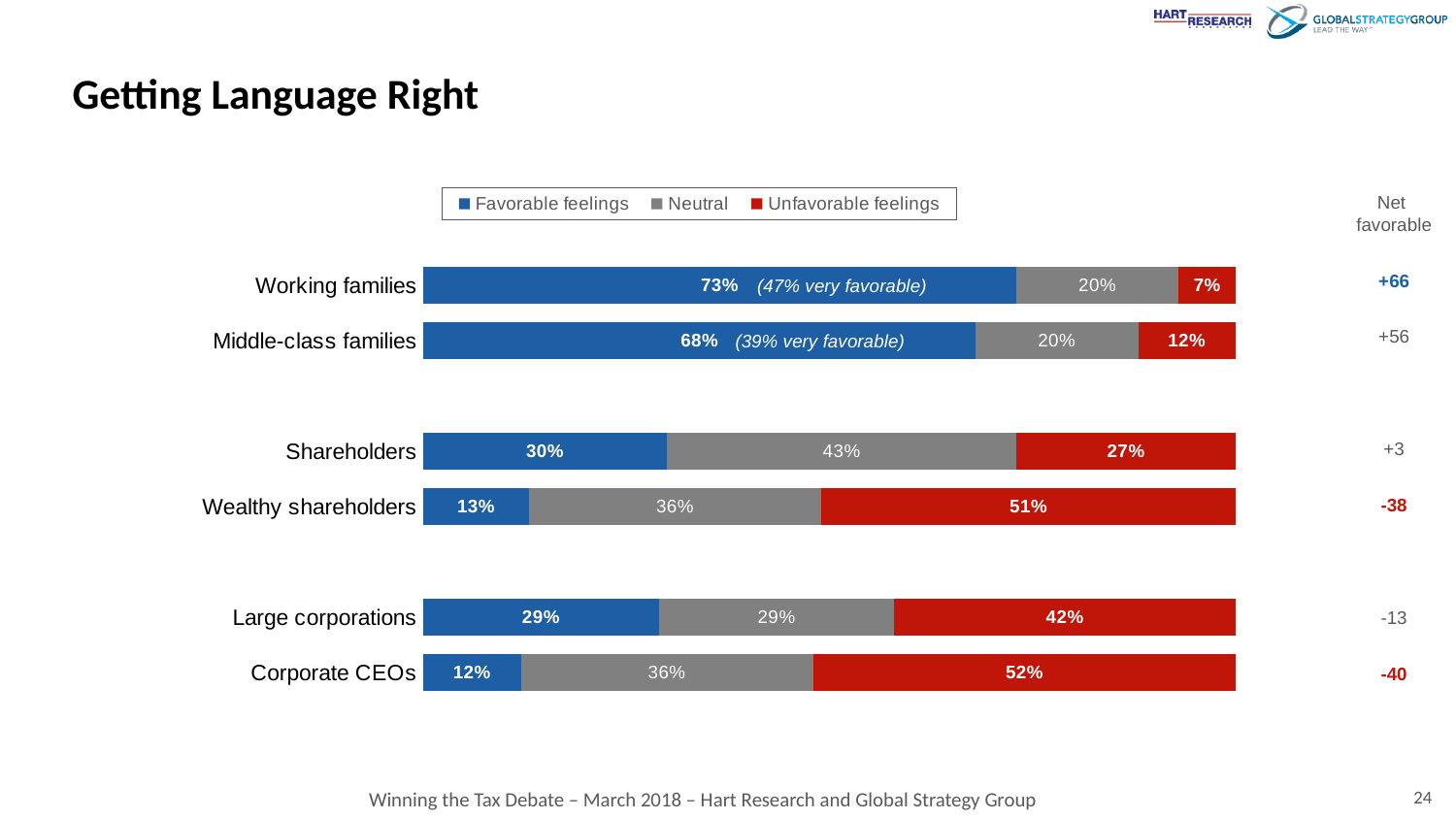
What percentage of respondents are very favorable toward working families, according to the note in the bar? 47% How many series does the legend list? 3 What is the difference between the favorable feelings values for working families and middle-class families? 5% What is the neutral value for shareholders? 43% Which has a larger unfavorable feelings value, large corporations or wealthy shareholders? Wealthy shareholders What percentage of respondents have favorable feelings toward working families? 73% What is the net favorable figure shown for wealthy shareholders? -38 Which category has the lowest favorable feelings value? Corporate CEOs What is the unfavorable feelings value for corporate CEOs? 52% Which category has the highest favorable feelings value? Working families How many categories are shown in the chart? 6 What kind of chart is shown on the slide? Stacked bar chart